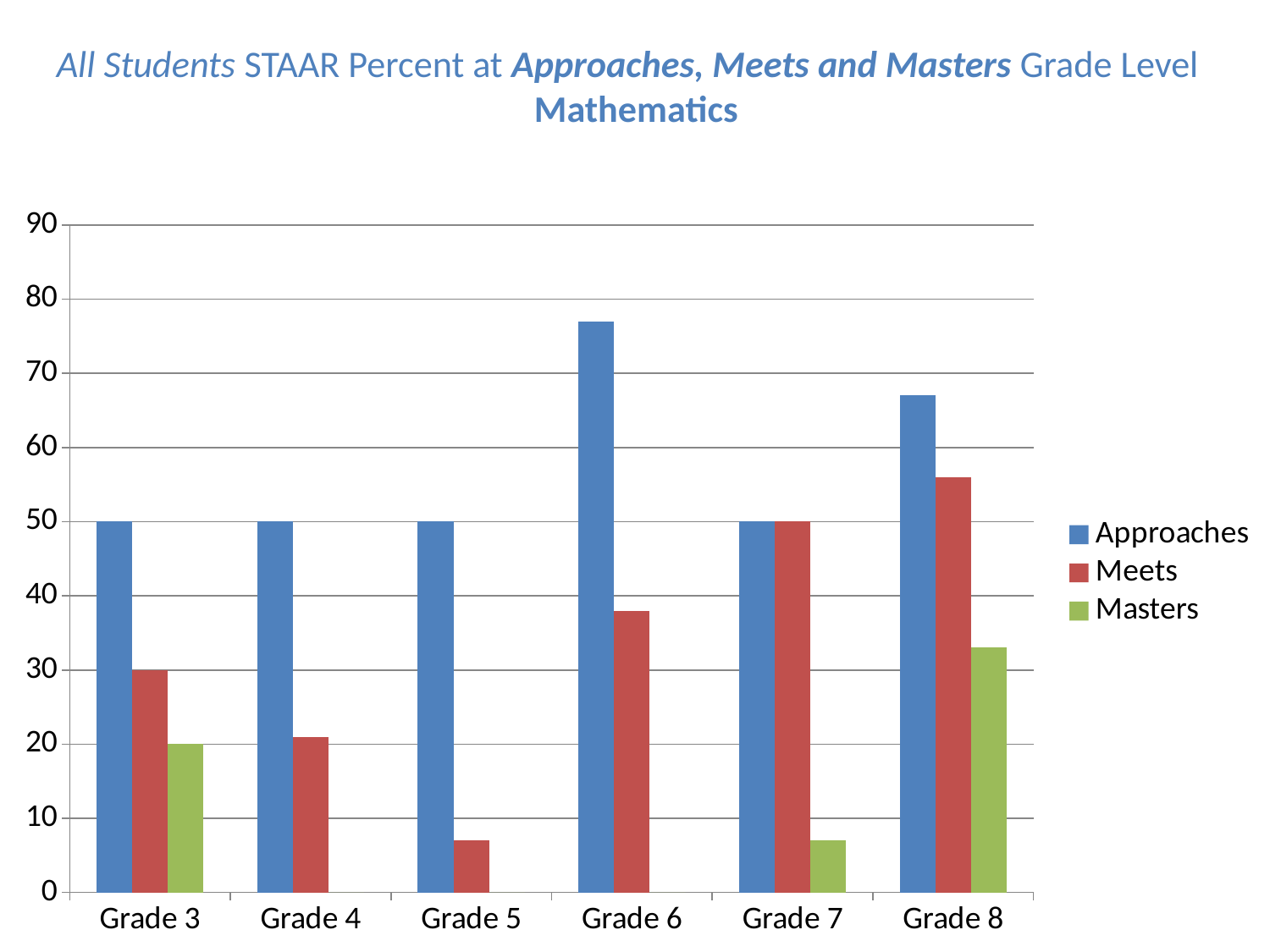
Which grade has the highest Approaches value? Grade 6 What is the Meets value for Grade 3? 30 How many grade levels are shown on the x axis? 6 Is the Approaches value for Grade 6 greater or less than 70? greater Which grade has the lowest Meets value? Grade 5 What is the Approaches value for Grade 3? 50 What kind of chart is shown on the slide? bar chart What are the three entries listed in the legend? Approaches, Meets, Masters How many series does the legend list? 3 Which grade has the highest Masters value? Grade 8 Which is larger, the Masters value for Grade 8 or the Masters value for Grade 3? Grade 8 Is the Meets value for Grade 4 greater or less than 30? less